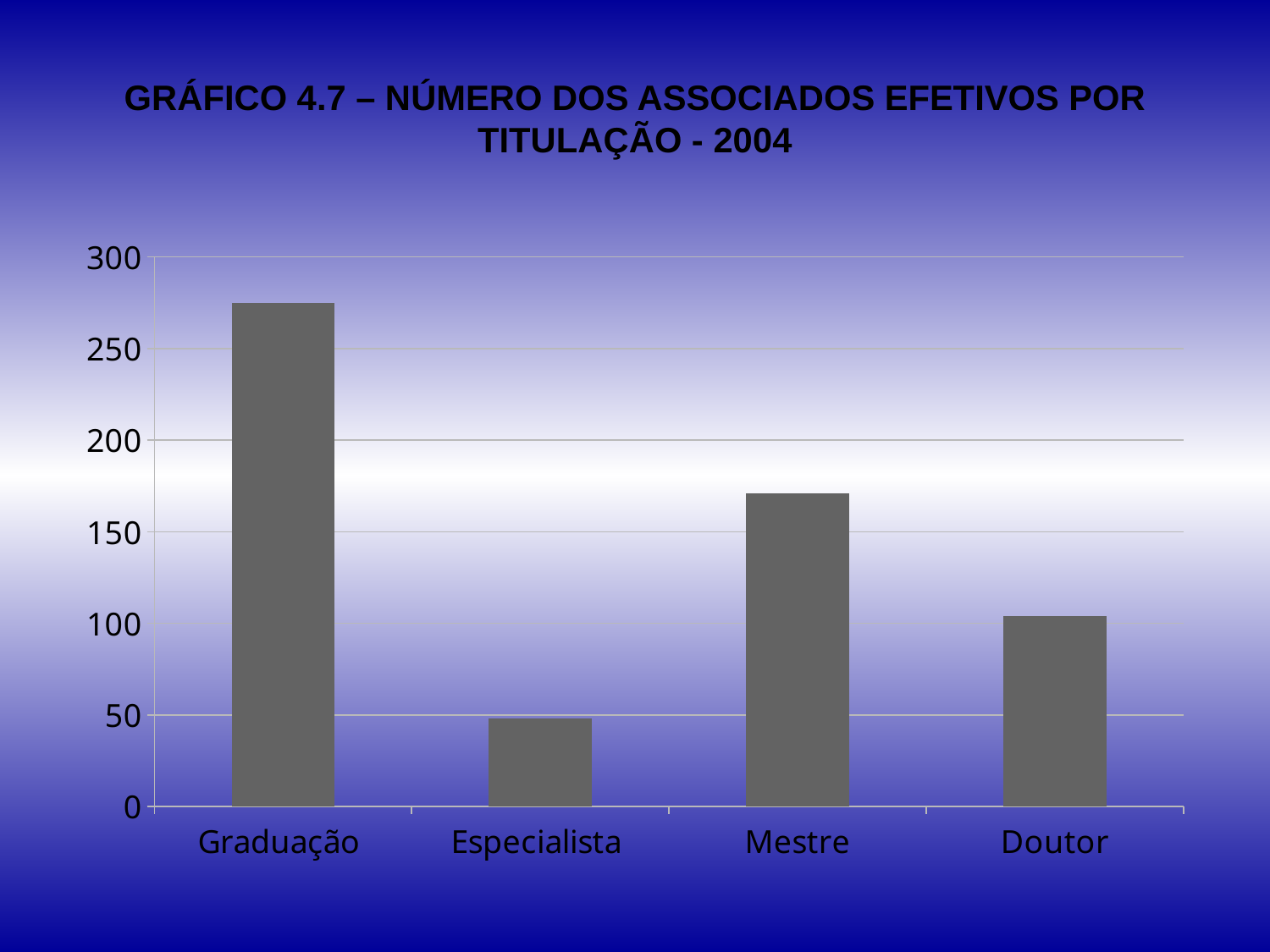
Which is larger, the value for Mestre or the value for Doutor? Mestre How many categories are shown on the x axis of the chart? 4 Is the value for Doutor greater or less than 150? less Is the value for Mestre greater or less than 150? greater Is the value for Especialista greater or less than 100? less What kind of chart is shown on the slide? bar chart Which category has the highest value in the chart? Graduação Which is larger, the value for Especialista or the value for Doutor? Doutor What is the title of the chart on the slide? GRÁFICO 4.7 – NÚMERO DOS ASSOCIADOS EFETIVOS POR TITULAÇÃO - 2004 Which category has the lowest value in the chart? Especialista